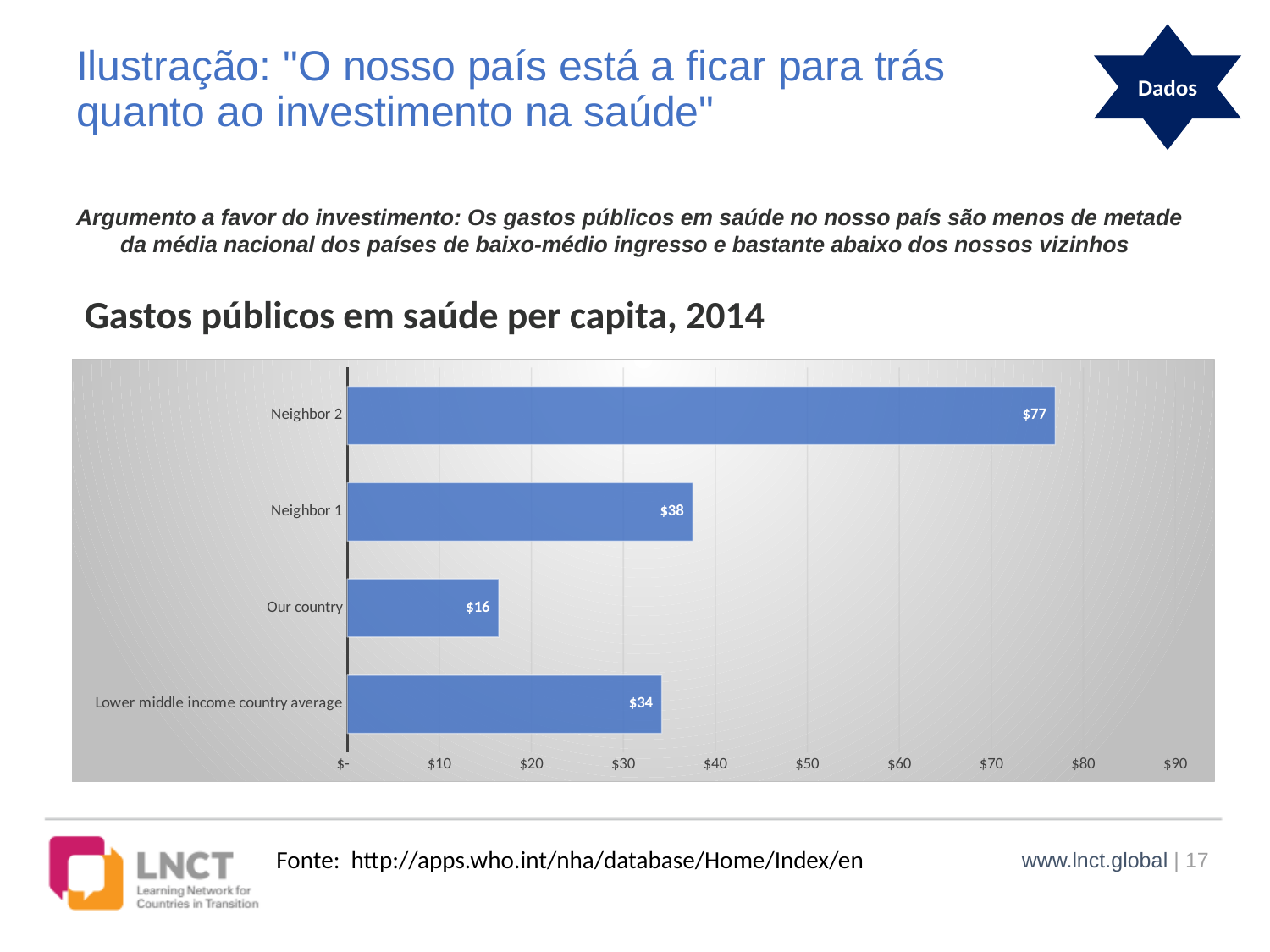
Which category has the lowest value in the chart? Our country What is the difference between the Lower middle income country average and Our country? $18 What is the title of the chart? Gastos públicos em saúde per capita, 2014 Which is larger, the value for Neighbor 1 or the Lower middle income country average? Neighbor 1 What is the value shown for Our country? $16 How many categories are shown in the chart? 4 What is the value for the Lower middle income country average? $34 What type of chart is shown on the slide? Bar chart Is the value for Neighbor 2 greater or less than $70? greater What is the public health expenditure per capita for Neighbor 2? $77 What is the difference between Neighbor 2 and Neighbor 1? $39 Which category has the highest public health expenditure per capita? Neighbor 2